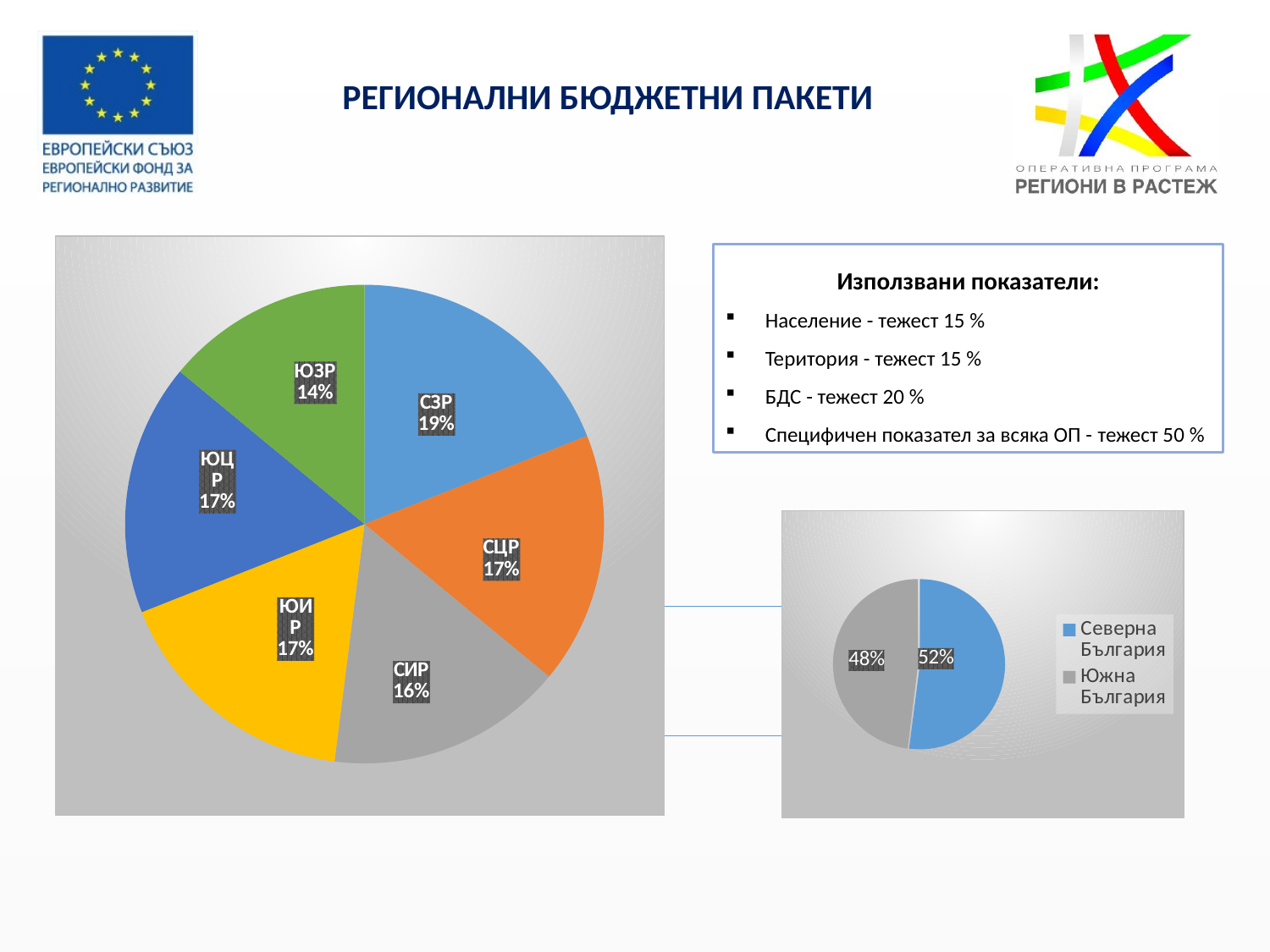
On the large pie chart on the left, what share does ЮЗР have? 14% On the large pie chart on the left, which is larger, the share of СЗР or the share of СИР? СЗР On the large pie chart on the left, which region has the largest share? СЗР On the large pie chart on the left, what share does СИР have? 16% On the small pie chart on the right, what share does Северна България have? 52% On the large pie chart on the left, how many slices are there? 6 On the small pie chart on the right, how many entries does the legend list? 2 On the large pie chart on the left, what share does СЗР have? 19% What kind of chart is the small chart on the right? Pie chart On the small pie chart on the right, what share does Южна България have? 48% On the large pie chart on the left, what is the difference between the shares of СЗР and ЮЗР? 5% On the large pie chart on the left, which region has the smallest share? ЮЗР